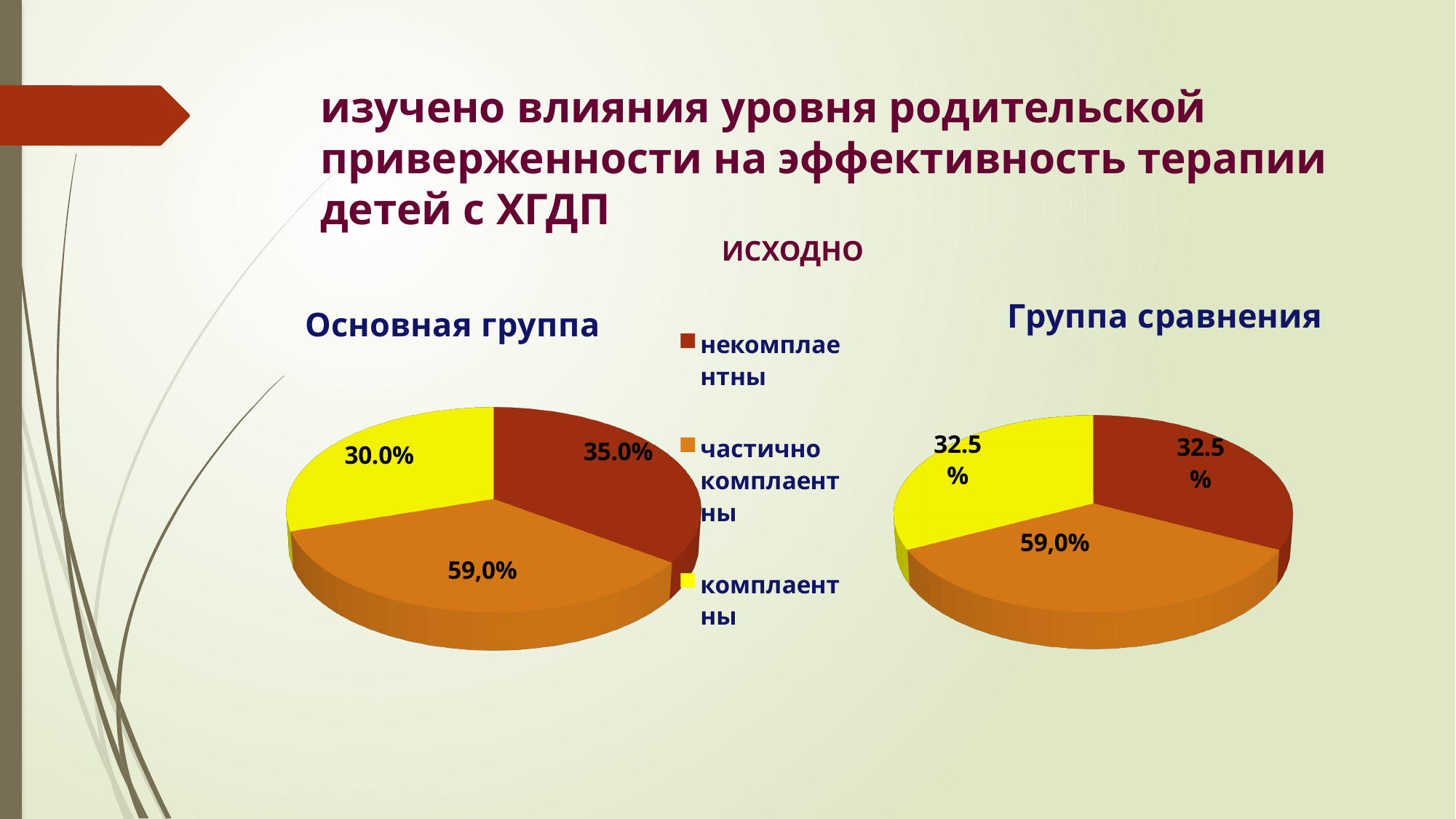
In the "Основная группа" chart, which is larger: "некомплаентны" or "комплаентны"? некомплаентны In the "Основная группа" chart, which category has the largest slice? частично комплаентны In the "Группа сравнения" chart, what is the value for "некомплаентны"? 32.5% In the "Группа сравнения" chart, which category has the largest slice? частично комплаентны In the "Группа сравнения" chart, what is the value for "частично комплаентны"? 59,0% In the "Основная группа" chart, what is the value for "комплаентны"? 30.0% In the "Основная группа" chart, what is the value for "некомплаентны"? 35.0% What kind of charts are shown on the slide? Pie charts In the "Основная группа" chart, what is the difference between "некомплаентны" and "комплаентны"? 5.0 percentage points How many categories does the legend list? 3 In the "Основная группа" chart, what is the value for "частично комплаентны"? 59,0% In the "Основная группа" chart, which category has the smallest slice? комплаентны